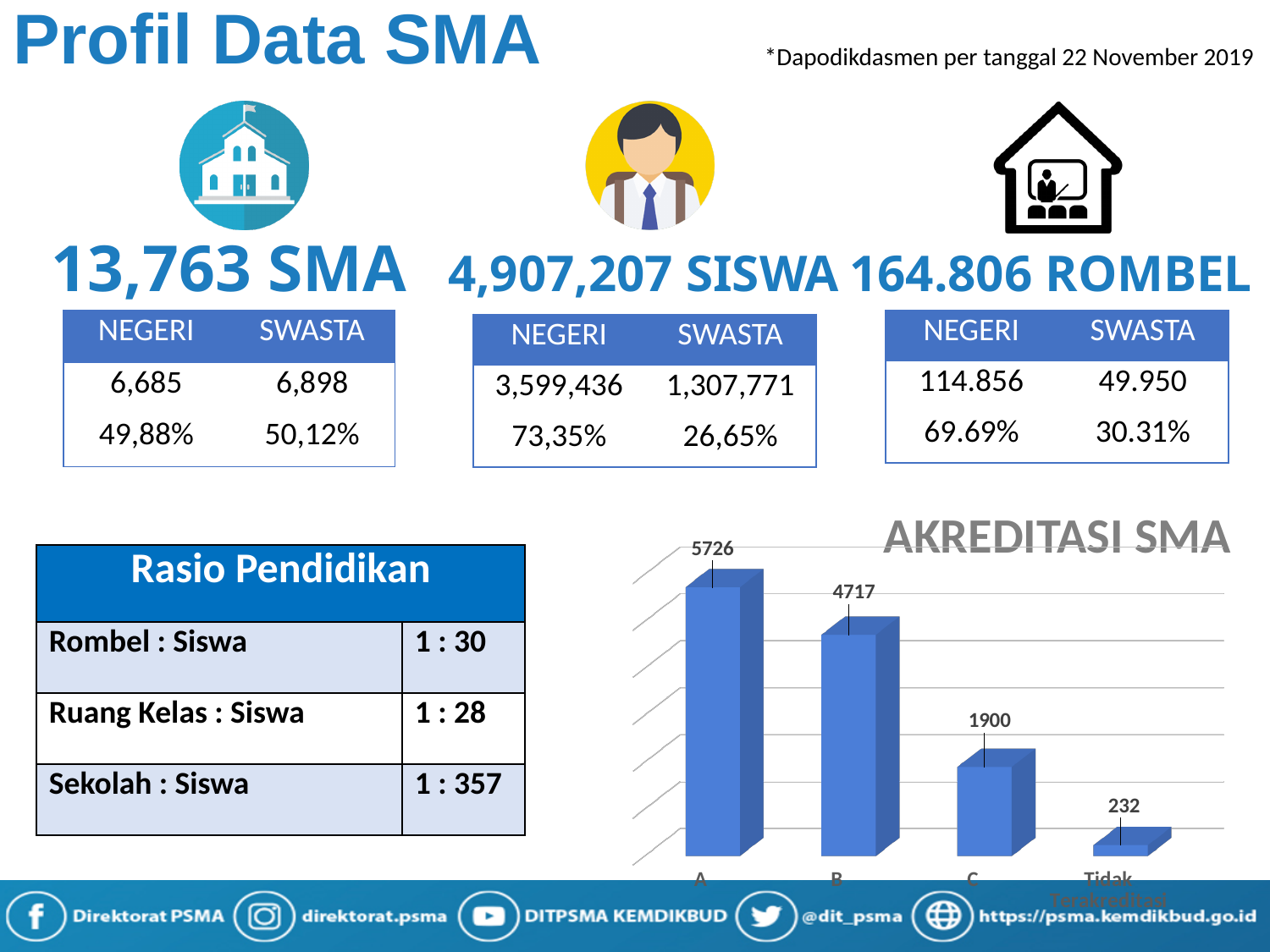
In the AKREDITASI SMA chart, what is the difference between the values for C and Tidak Terakreditasi? 1668 Which category has the lowest value in the AKREDITASI SMA chart? Tidak Terakreditasi In the AKREDITASI SMA chart, what is the value for category B? 4717 What type of chart is the AKREDITASI SMA chart? bar chart In the AKREDITASI SMA chart, what is the value for category C? 1900 How many categories are shown in the AKREDITASI SMA chart? 4 Which category has the highest value in the AKREDITASI SMA chart? A Do the values in the AKREDITASI SMA chart rise or fall from left to right along the x axis? fall In the AKREDITASI SMA chart, what is the value for Tidak Terakreditasi? 232 In the AKREDITASI SMA chart, what is the value for category A? 5726 In the AKREDITASI SMA chart, what is the difference between the values for A and B? 1009 In the AKREDITASI SMA chart, which is larger, the value for B or the value for C? B